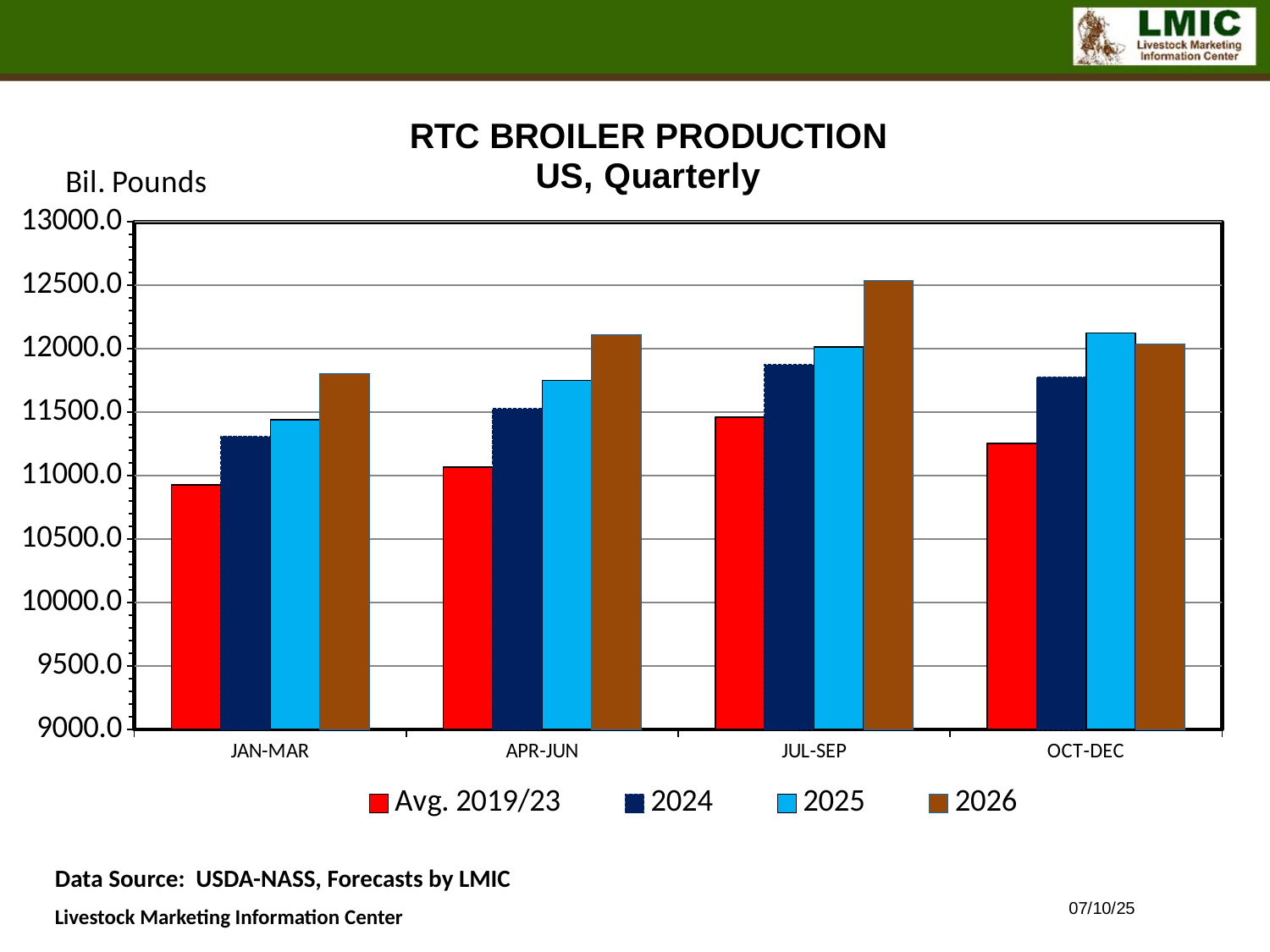
Is the 2025 value for OCT-DEC greater or less than 12000.0? greater Does the 2026 series rise or fall from JAN-MAR to JUL-SEP? rise Is the 2026 value for APR-JUN greater or less than 12000.0? greater In JUL-SEP, which is larger, the 2025 value or the 2026 value? 2026 Which quarter has the highest 2026 value? JUL-SEP Which quarter has the lowest Avg. 2019/23 value? JAN-MAR Is the Avg. 2019/23 value for JAN-MAR greater or less than 11000.0? less What kind of chart is shown on the slide? bar chart How many quarter categories are shown on the x axis? 4 What unit is shown on the y axis label? Bil. Pounds How many series does the legend list? 4